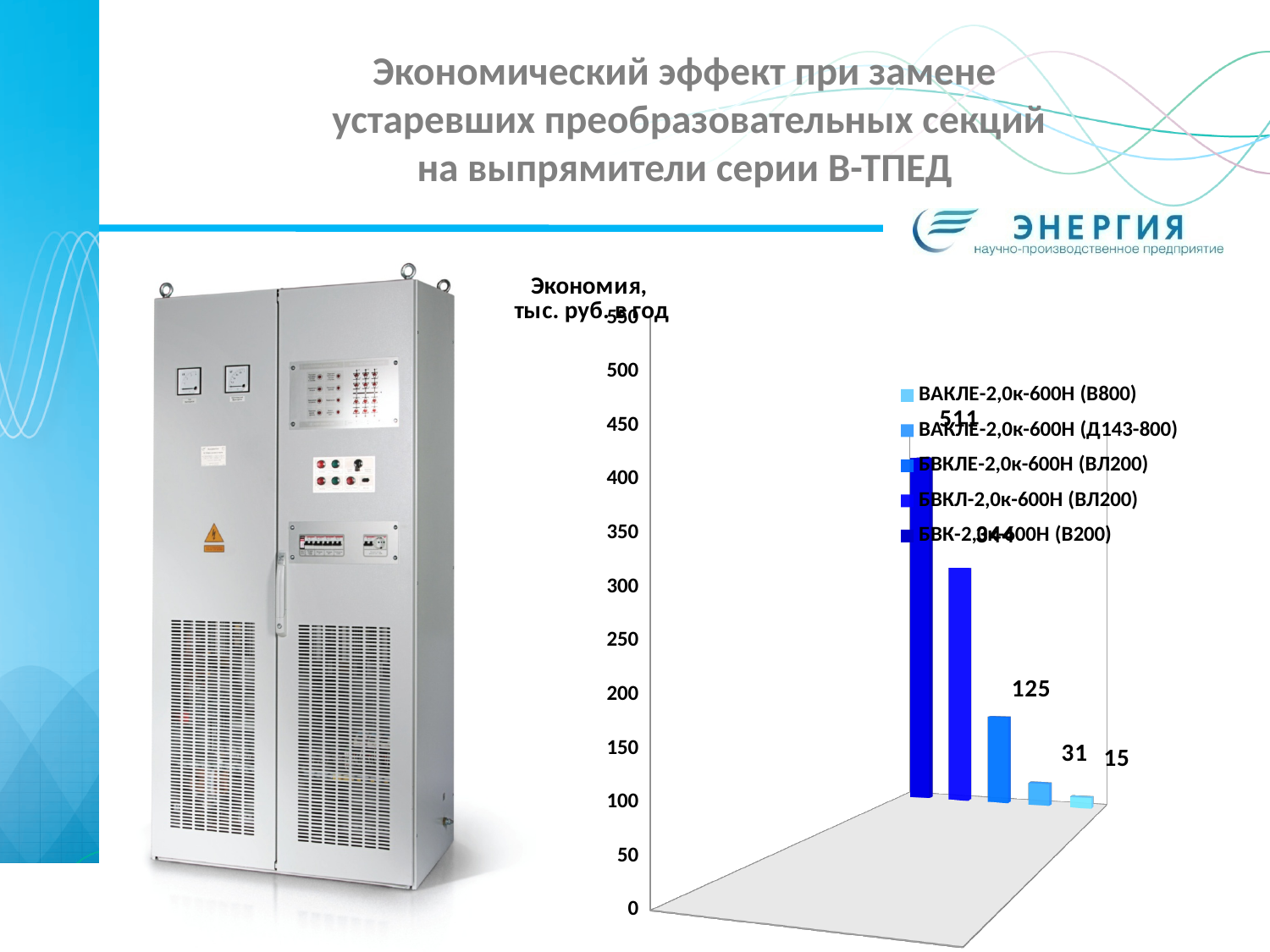
Which series has the lowest value in the chart? ВАКЛЕ-2,0к-600Н (В800) Which is larger: the bar labelled 125 or the bar labelled 31? 125 What kind of chart is shown on the slide? bar chart What is the value for ВАКЛЕ-2,0к-600Н (В800)? 15 How many series does the chart legend list? 5 Do the bar values rise or fall from left to right across the chart? fall What is the value of the tallest bar in the chart? 511 What is the value of the third bar from the left? 125 How many bars are plotted in the chart? 5 Which series has the highest value in the chart? БВК-2,0к-600Н (В200) What is the difference between the bars labelled 31 and 15? 16 What is the difference between the highest bar (511) and the bar labelled 125? 386